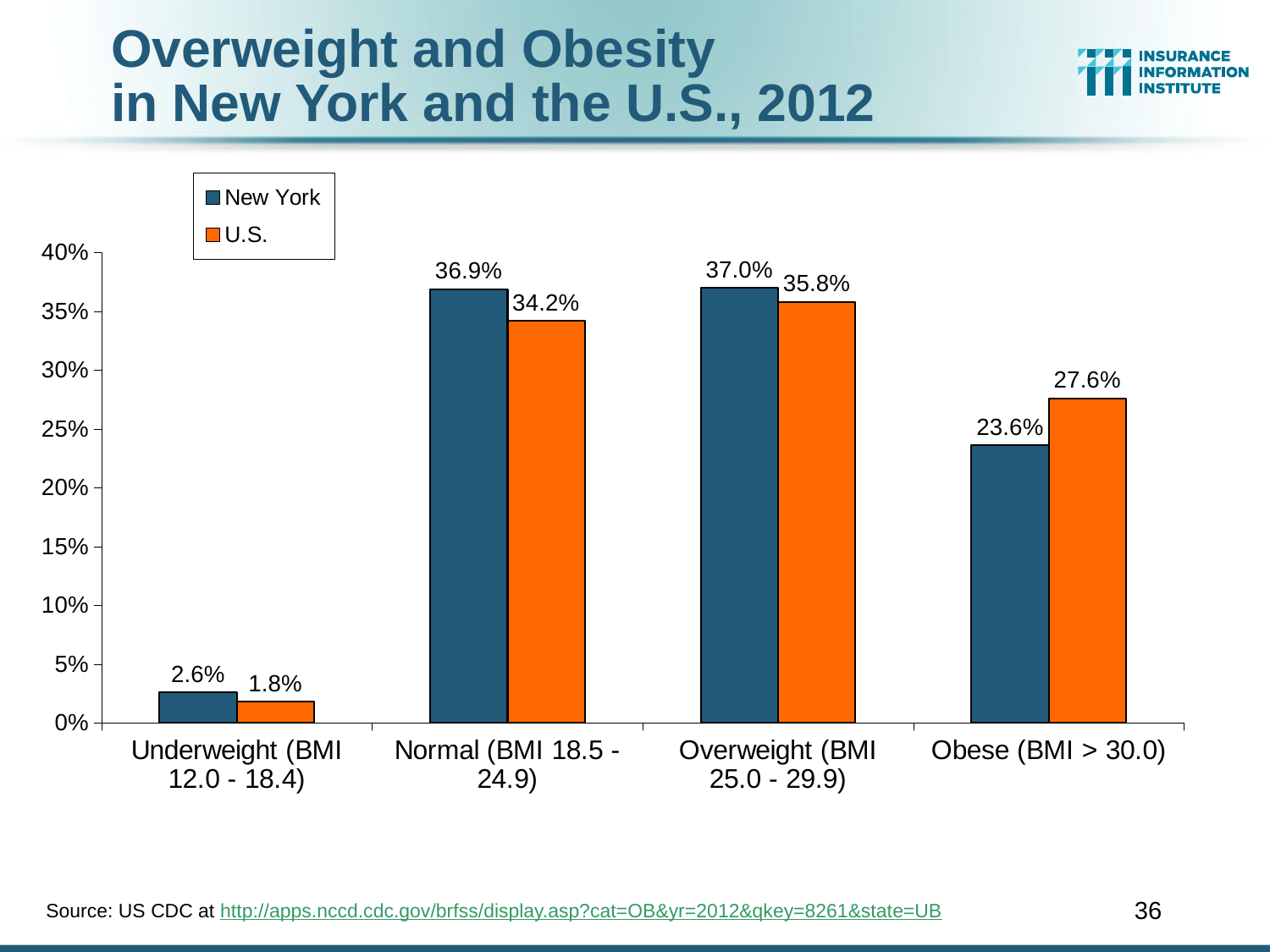
How many series does the legend list? 2 What is the difference between the U.S. and New York values for the Obese (BMI > 30.0) category? 4.0% Which category has the highest U.S. value? Overweight (BMI 25.0 - 29.9) What is the difference between the New York and U.S. values for the Normal (BMI 18.5 - 24.9) category? 2.7% How many categories are shown on the x axis? 4 What is the U.S. value for the Underweight (BMI 12.0 - 18.4) category? 1.8% Which category has the lowest New York value? Underweight (BMI 12.0 - 18.4) For the Obese (BMI > 30.0) category, which is larger: the New York value or the U.S. value? U.S. What kind of chart is shown on the slide? Bar chart What is the U.S. value for the Obese (BMI > 30.0) category? 27.6% For the Overweight (BMI 25.0 - 29.9) category, which is larger: the New York value or the U.S. value? New York What is the New York value for the Normal (BMI 18.5 - 24.9) category? 36.9%